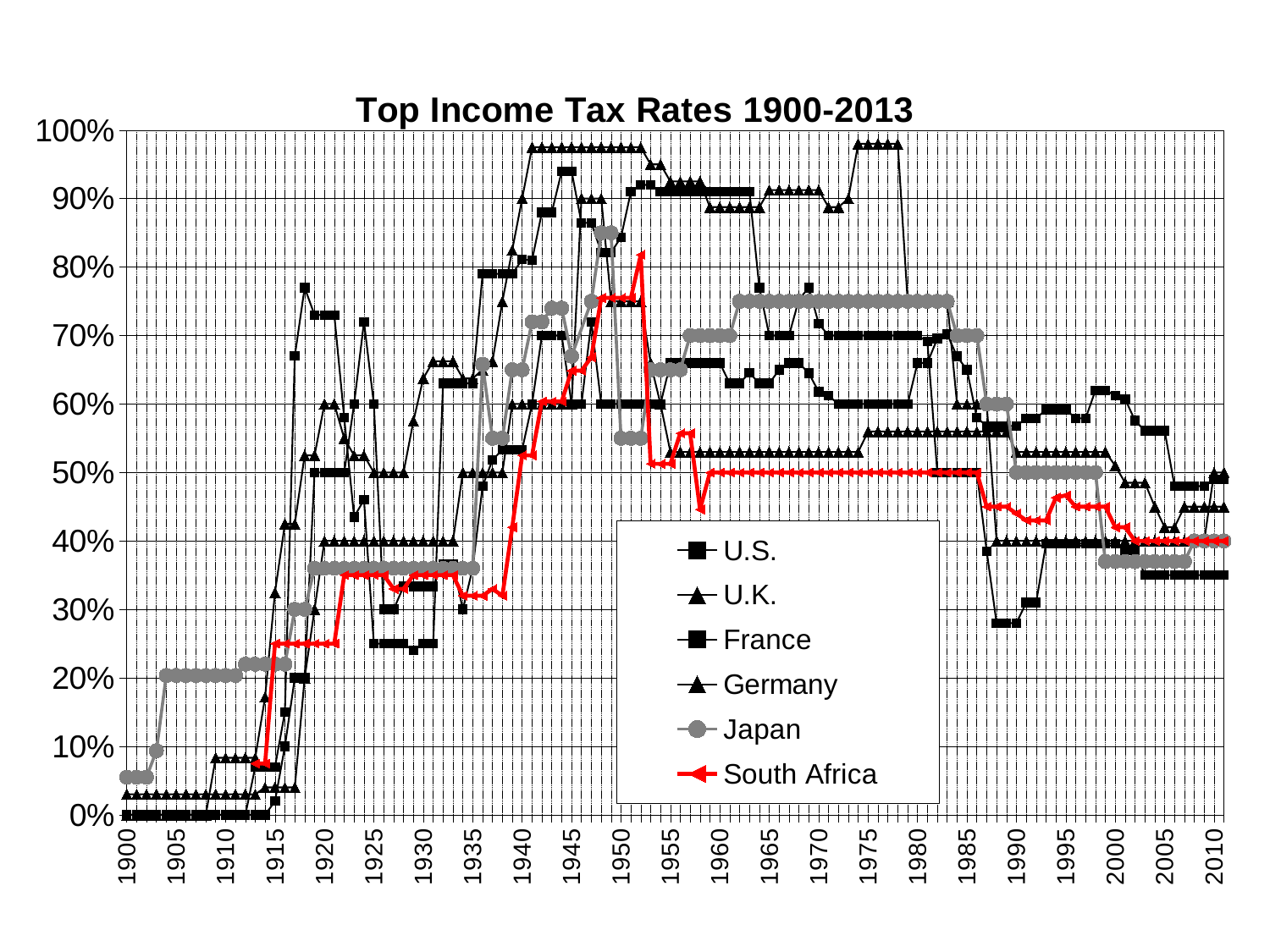
Which series is drawn in red? South Africa Does the value for Japan rise or fall from 1975 to 2010? fall Is the value for South Africa in 1925 greater or less than 30%? greater What is the title of the chart? Top Income Tax Rates 1900-2013 Is the value for South Africa in 1990 greater or less than 40%? greater How many series does the legend list? 6 Is the value for Japan in 2005 greater or less than 40%? less In 1975, which is larger, the value for Japan or the value for South Africa? Japan What kind of chart is shown on the slide? line chart